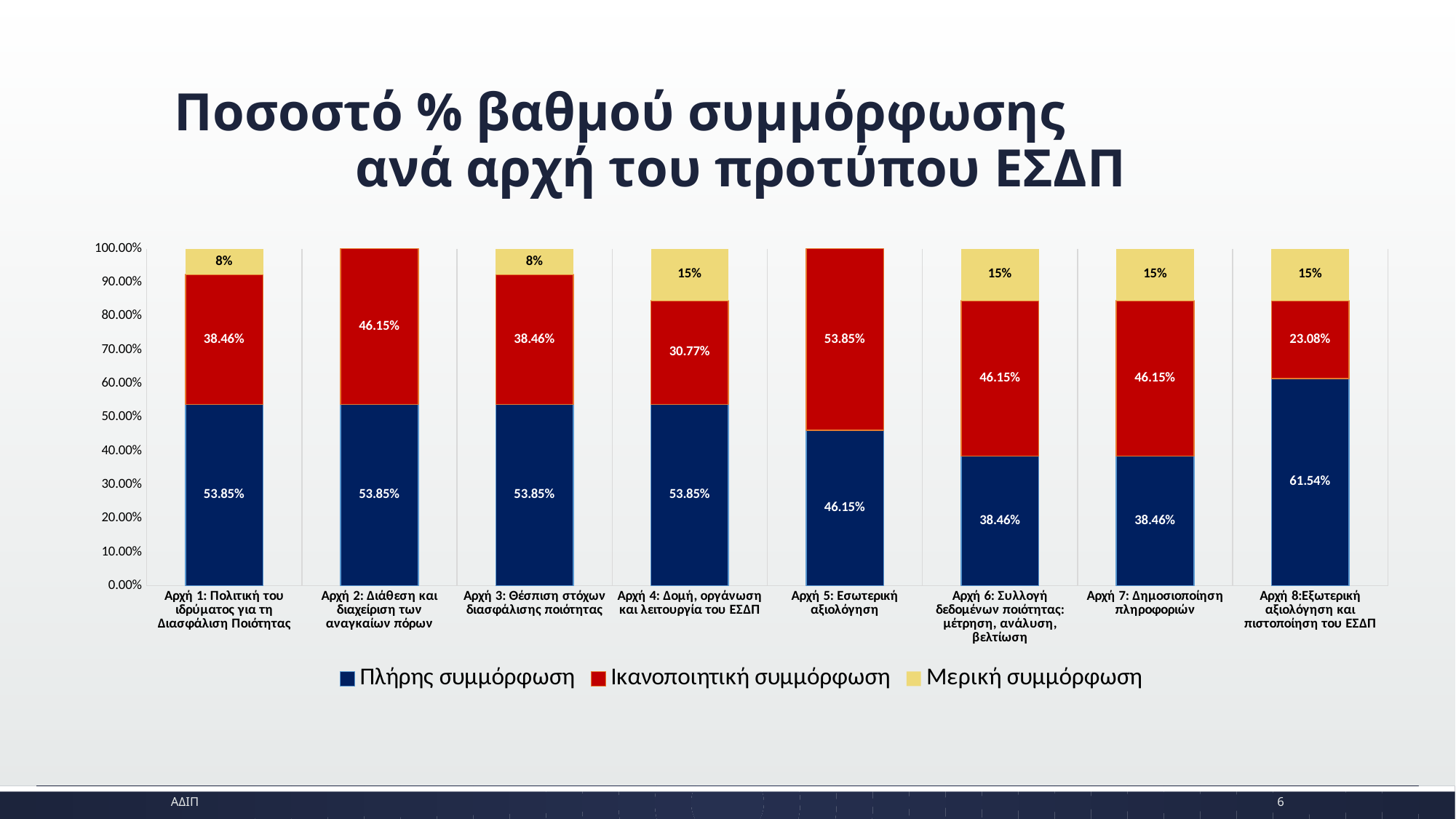
Which is larger: Πλήρης συμμόρφωση for Αρχή 5 or Ικανοποιητική συμμόρφωση for Αρχή 5? Ικανοποιητική συμμόρφωση Which category has the highest value for Πλήρης συμμόρφωση? Αρχή 8: Εξωτερική αξιολόγηση και πιστοποίηση του ΕΣΔΠ How many series does the legend list? 3 How many categories (αρχές) are shown on the x axis? 8 Which category has the lowest value for Ικανοποιητική συμμόρφωση? Αρχή 8: Εξωτερική αξιολόγηση και πιστοποίηση του ΕΣΔΠ What is the difference between the Πλήρης συμμόρφωση values for Αρχή 8 and Αρχή 6? 23.08% Which category has the highest value for Ικανοποιητική συμμόρφωση? Αρχή 5: Εσωτερική αξιολόγηση What is the value of Πλήρης συμμόρφωση for Αρχή 5: Εσωτερική αξιολόγηση? 46.15% What is the value of Μερική συμμόρφωση for Αρχή 1: Πολιτική του ιδρύματος για τη Διασφάλιση Ποιότητας? 8% What is the value of Πλήρης συμμόρφωση for Αρχή 8: Εξωτερική αξιολόγηση και πιστοποίηση του ΕΣΔΠ? 61.54% What is the value of Ικανοποιητική συμμόρφωση for Αρχή 4: Δομή, οργάνωση και λειτουργία του ΕΣΔΠ? 30.77% What kind of chart is shown on the slide? Stacked bar chart